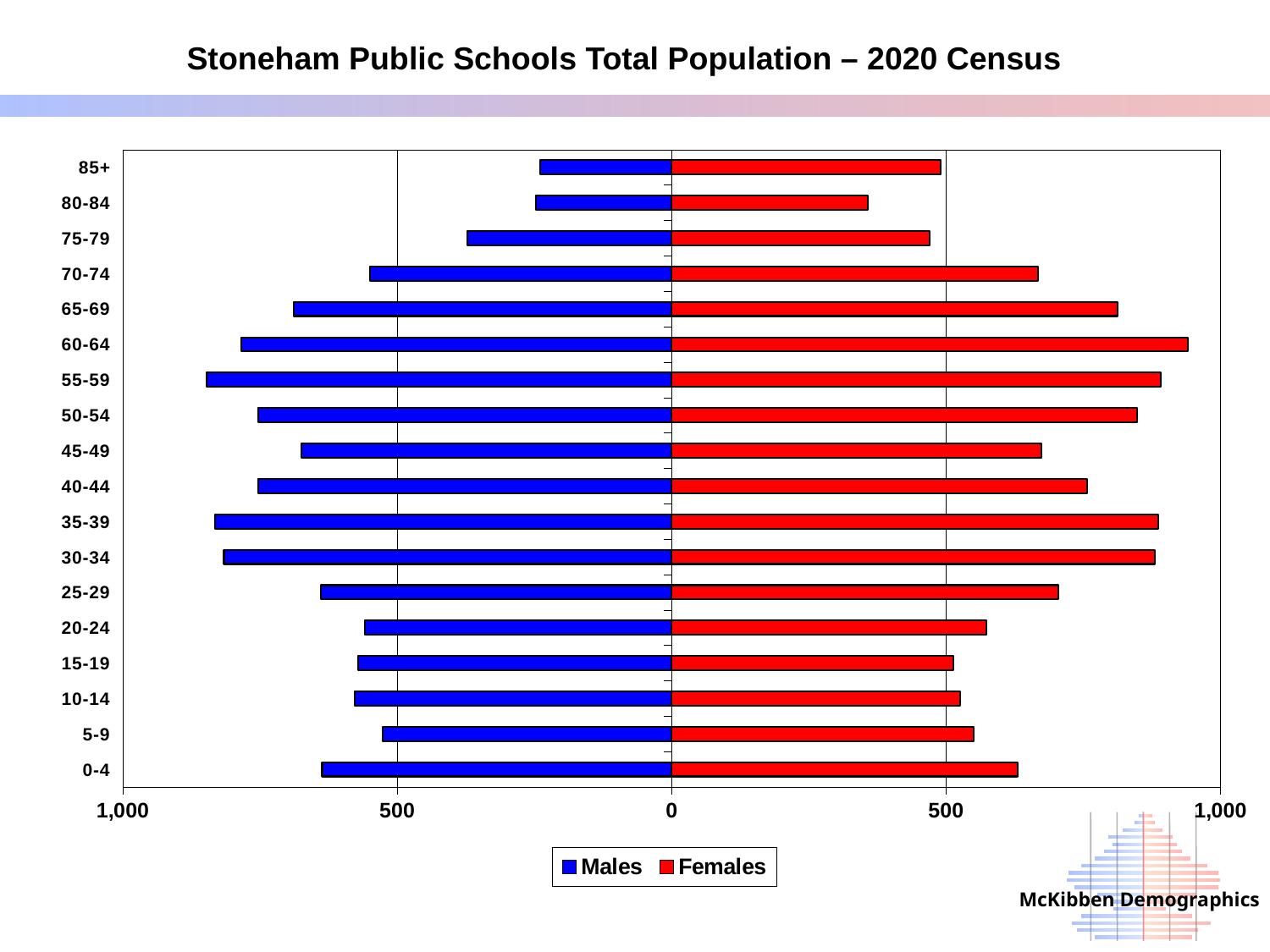
Is the value for Males in the 70-74 age group greater or less than 500? greater Is the value for Males in the 75-79 age group greater or less than 500? less How many age groups are shown on the vertical axis? 18 Is the value for Females in the 60-64 age group greater or less than 500? greater In the 80-84 age group, which is larger, Males or Females? Females Which age group has the lowest value for Females? 80-84 What kind of chart is shown on the slide? bar chart In the 60-64 age group, which is larger, Males or Females? Females Which age group has the highest value for Females? 60-64 How many series does the legend list? 2 What colour represents Females in the chart? red